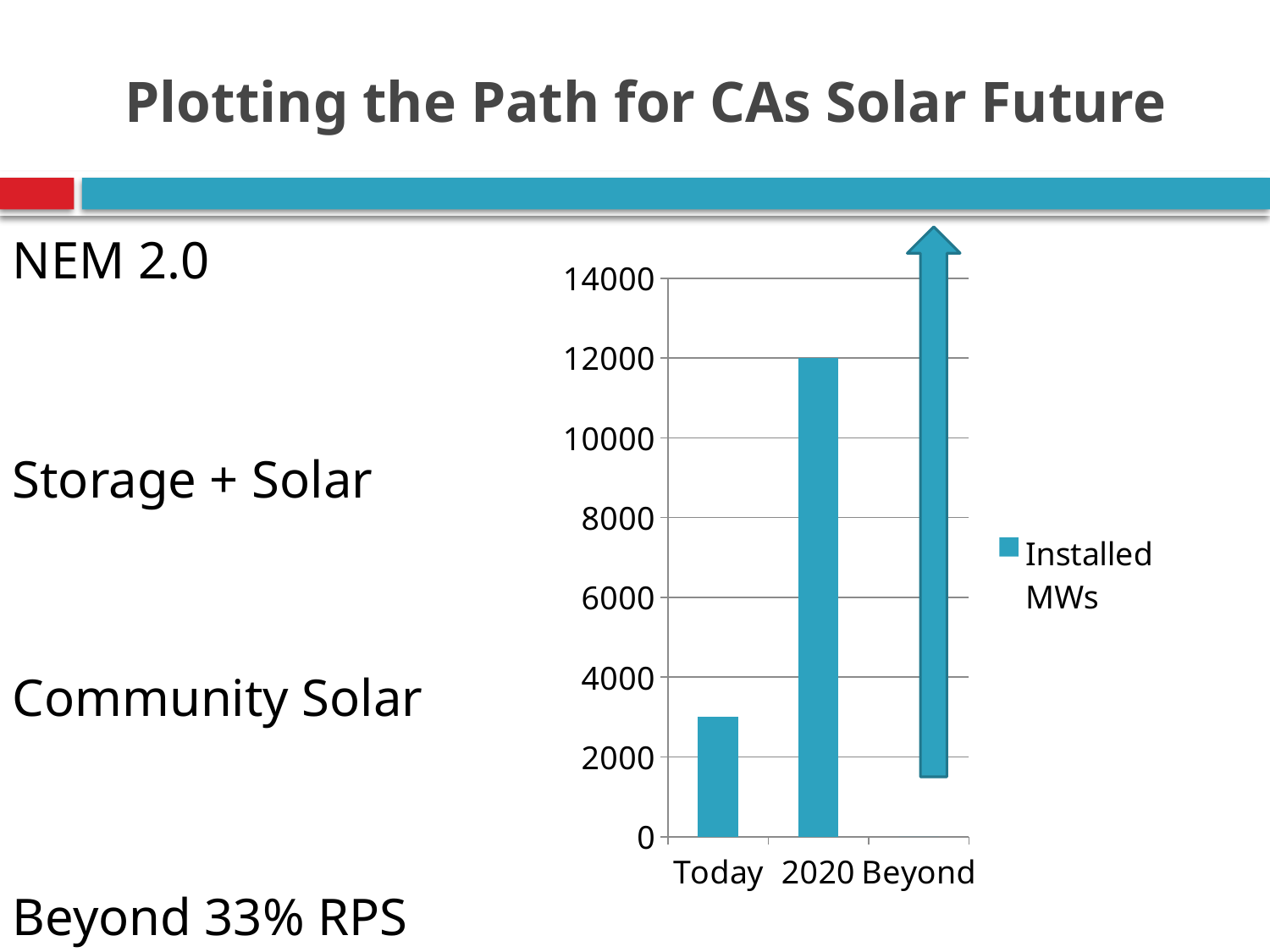
Which is larger, the value for Today or the value for 2020? 2020 Which category has the tallest bar in the chart? 2020 Is the value for Today greater or less than 4000? less What is the name of the series in the chart legend? Installed MWs Is the value for 2020 greater or less than 10000? greater Do the bar values rise or fall from Today to 2020? rise What type of chart is shown on the slide? bar chart What is the value for 2020 in the Installed MWs chart? 12000 What is the highest value labelled on the vertical axis of the chart? 14000 How many categories are shown on the x axis of the chart? 3 How many series does the chart legend list? 1 Is the value for Today greater or less than 2000? greater